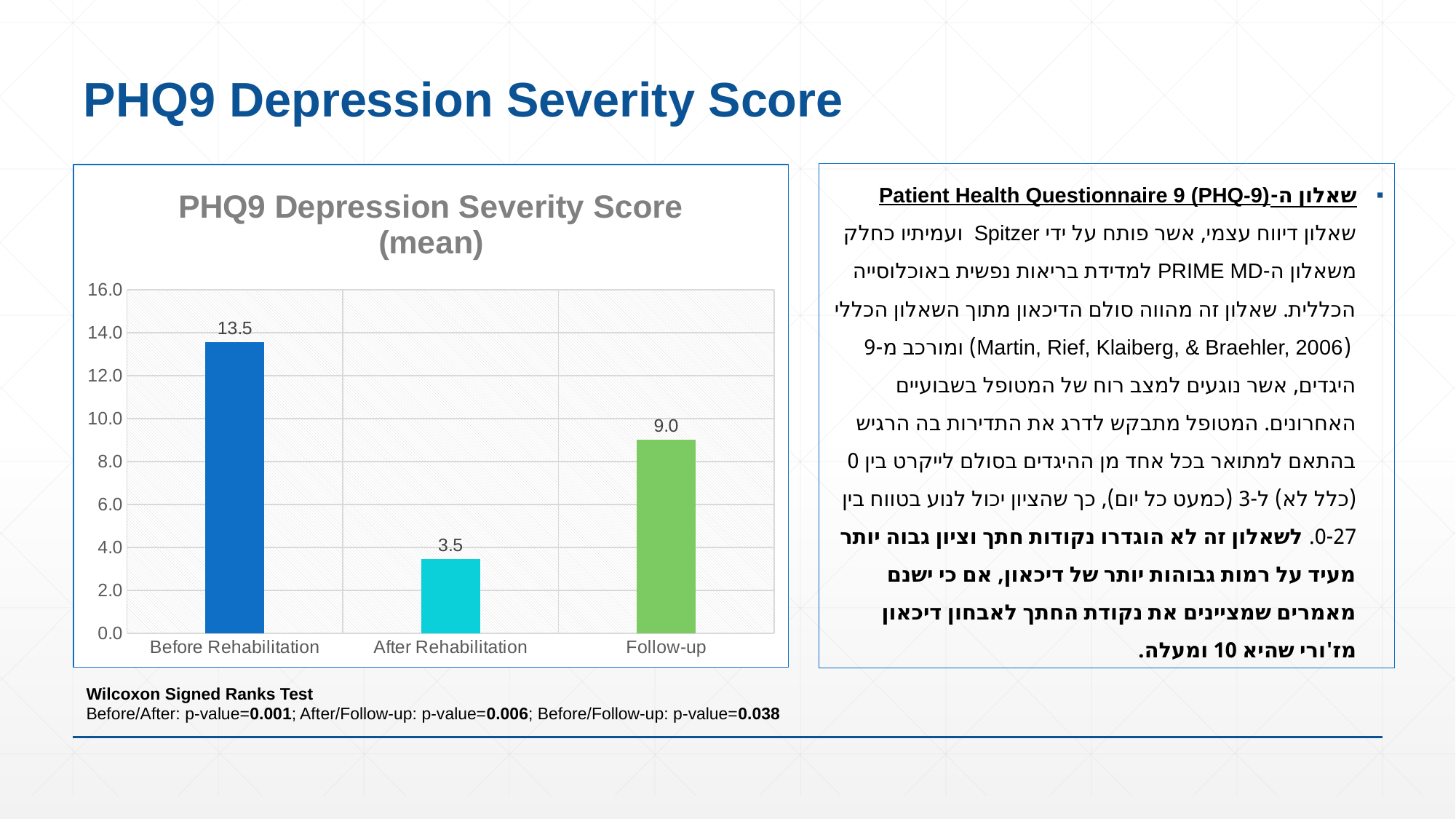
How many categories are shown on the x axis of the chart? 3 What is the difference between the Follow-up and After Rehabilitation mean scores? 5.5 What is the mean PHQ9 Depression Severity Score at Follow-up? 9.0 What is the mean PHQ9 Depression Severity Score for Before Rehabilitation? 13.5 What is the mean PHQ9 Depression Severity Score for After Rehabilitation? 3.5 Is the mean score for Before Rehabilitation greater or less than 12.0? greater Which category has the highest mean PHQ9 Depression Severity Score? Before Rehabilitation Which category has the lowest mean PHQ9 Depression Severity Score? After Rehabilitation What is the title of the chart? PHQ9 Depression Severity Score (mean) Which is larger, the mean score at Follow-up or After Rehabilitation? Follow-up What is the difference between the Before Rehabilitation and After Rehabilitation mean scores? 10.0 What kind of chart is shown on the slide? bar chart